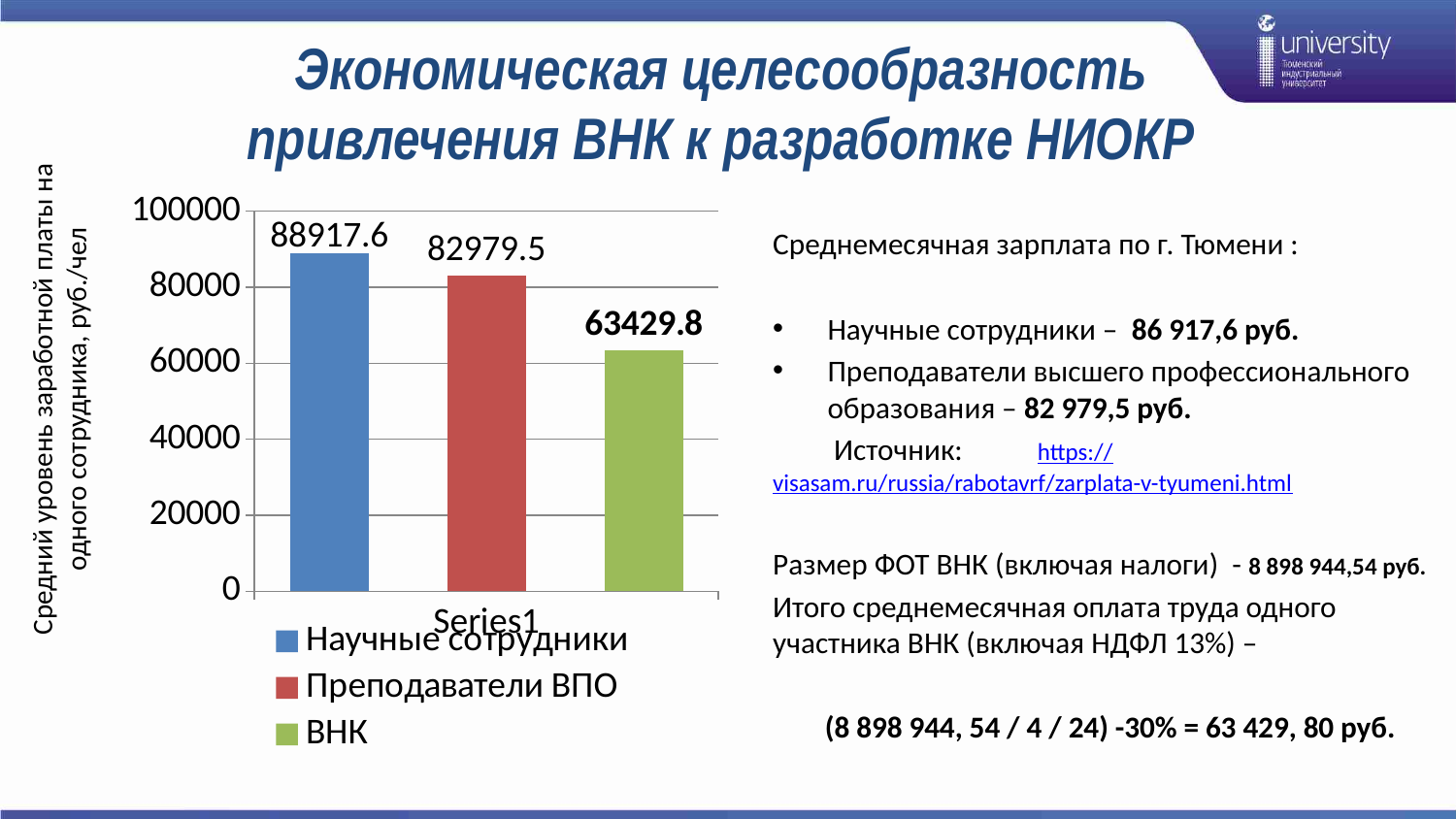
Which series has the lowest value in the chart? ВНК What is the value shown for ВНК? 63429.8 What is the difference between the values for Научные сотрудники and Преподаватели ВПО? 5938.1 What is the value shown for Научные сотрудники? 88917.6 Is the value for ВНК greater or less than 80000? less What kind of chart is shown on the slide? bar chart How many series does the legend list? 3 What is the difference between the values for Преподаватели ВПО and ВНК? 19549.7 Which is larger, the value for Преподаватели ВПО or the value for ВНК? Преподаватели ВПО What is the value shown for Преподаватели ВПО? 82979.5 What colour is the bar for ВНК? green Which series has the highest value in the chart? Научные сотрудники